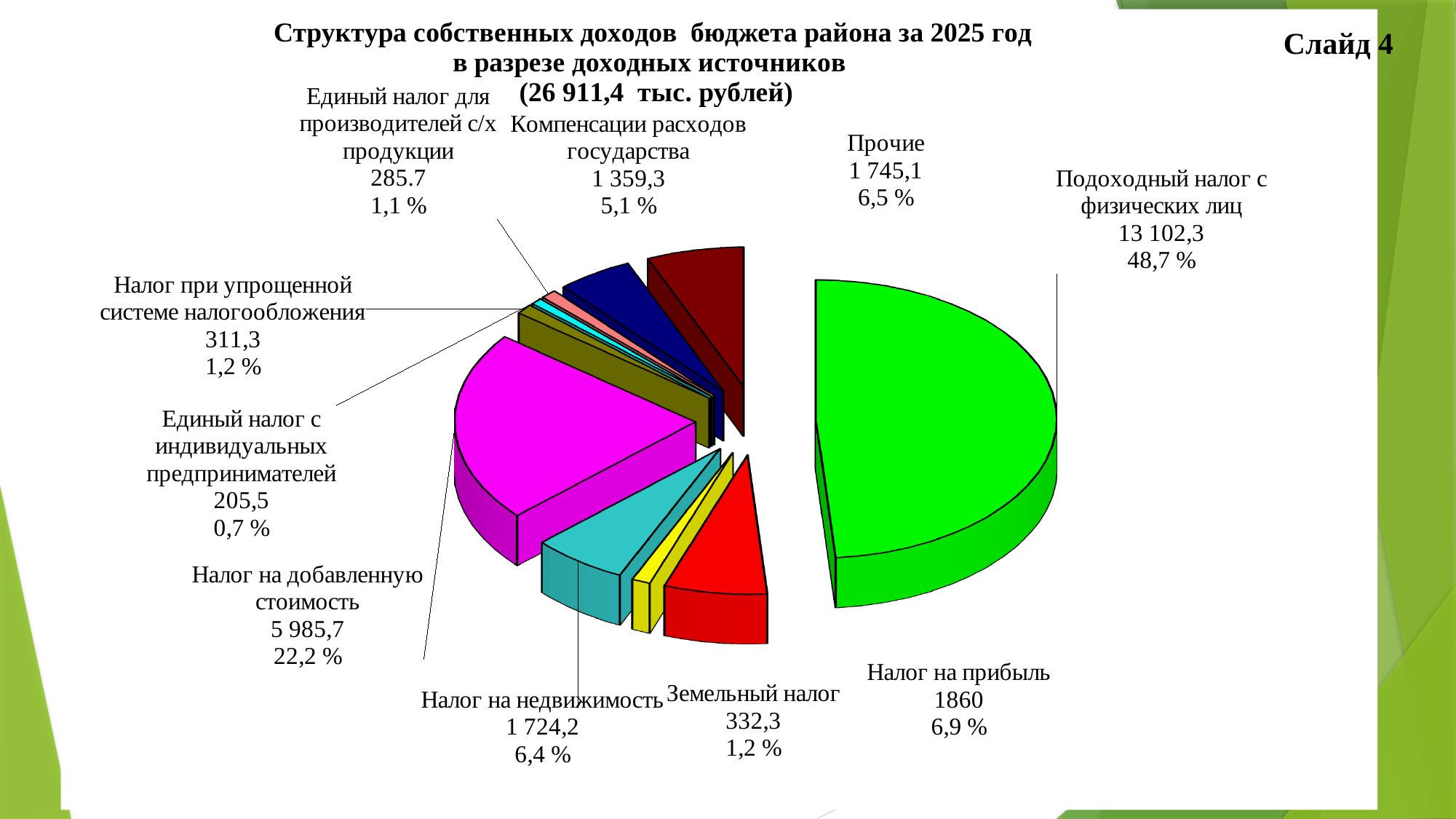
Which income source has the largest share of the pie? Подоходный налог с физических лиц Which is larger: Налог на прибыль or Налог на недвижимость? Налог на прибыль What is the value for Налог на добавленную стоимость? 5 985,7 What share of the pie does Прочие represent? 6,5 % What kind of chart is shown on the slide? pie chart Which income source has the smallest share of the pie? Единый налог с индивидуальных предпринимателей What share of the pie does Налог на прибыль represent? 6,9 % How many categories (income sources) are shown in the pie chart? 10 What is the value for Компенсации расходов государства? 1 359,3 What is the value for Подоходный налог с физических лиц? 13 102,3 What total amount (in тыс. рублей) is stated in the chart title? 26 911,4 What is the difference between the values for Налог на прибыль (1860) and Налог на недвижимость (1 724,2)? 135,8